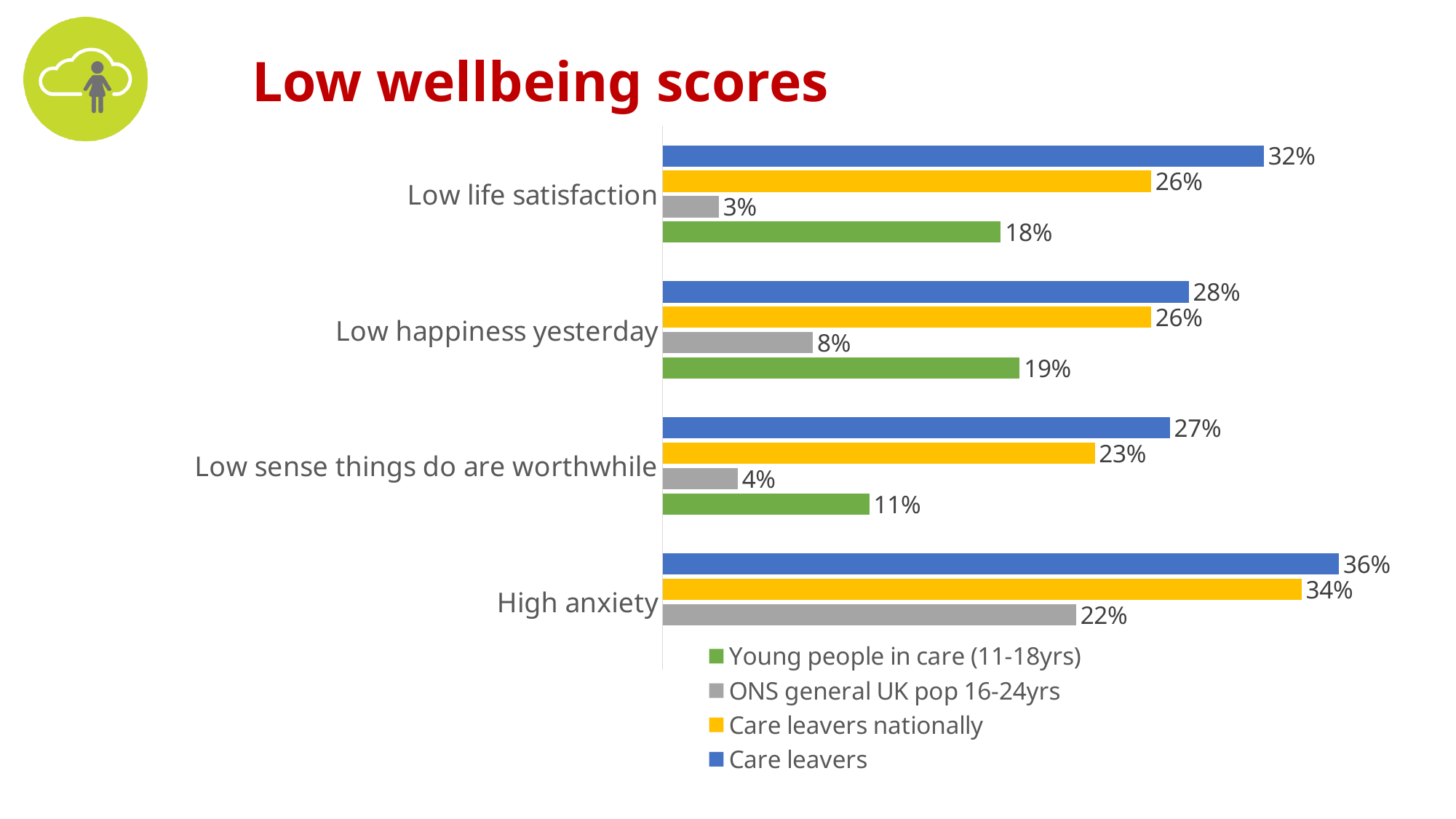
Which is larger for Low happiness yesterday: the value for Care leavers or the value for Young people in care (11-18yrs)? Care leavers What is the value for Care leavers nationally for High anxiety? 34% Which category has the lowest value for ONS general UK pop 16-24yrs? Low life satisfaction How many series does the legend list? 4 What is the value for ONS general UK pop 16-24yrs for Low happiness yesterday? 8% Which category has the highest value for Care leavers? High anxiety What kind of chart is shown on the slide? Bar chart What is the title of the slide? Low wellbeing scores What is the value for Care leavers for Low life satisfaction? 32% What is the difference between the Care leavers value and the ONS general UK pop 16-24yrs value for Low life satisfaction? 29% How many categories are shown on the chart? 4 What is the value for Young people in care (11-18yrs) for Low sense things do are worthwhile? 11%